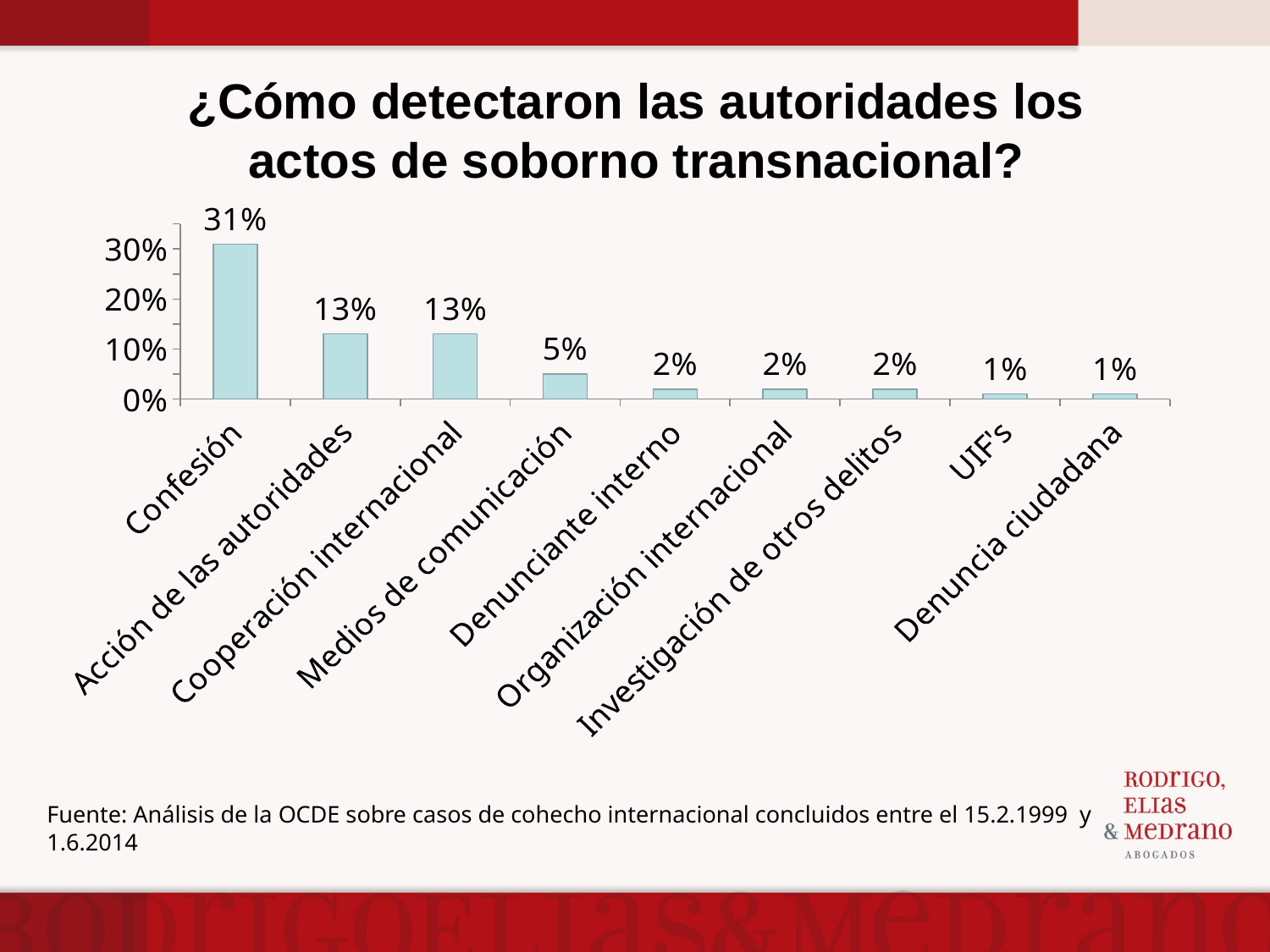
What is the value for Denuncia ciudadana? 1% How many categories are shown on the x axis? 9 What is the difference between the values for Medios de comunicación and Denunciante interno? 3% What is the value for Medios de comunicación? 5% Is the value for Confesión greater or less than 20%? greater Do the values rise or fall from left to right along the x axis? fall What kind of chart is shown on the slide? bar chart What is the value for Cooperación internacional? 13% What is the difference between the values for Confesión and Acción de las autoridades? 18% What is the value for Confesión? 31% Which is larger, the value for Medios de comunicación or the value for UIF's? Medios de comunicación Which category has the highest value? Confesión